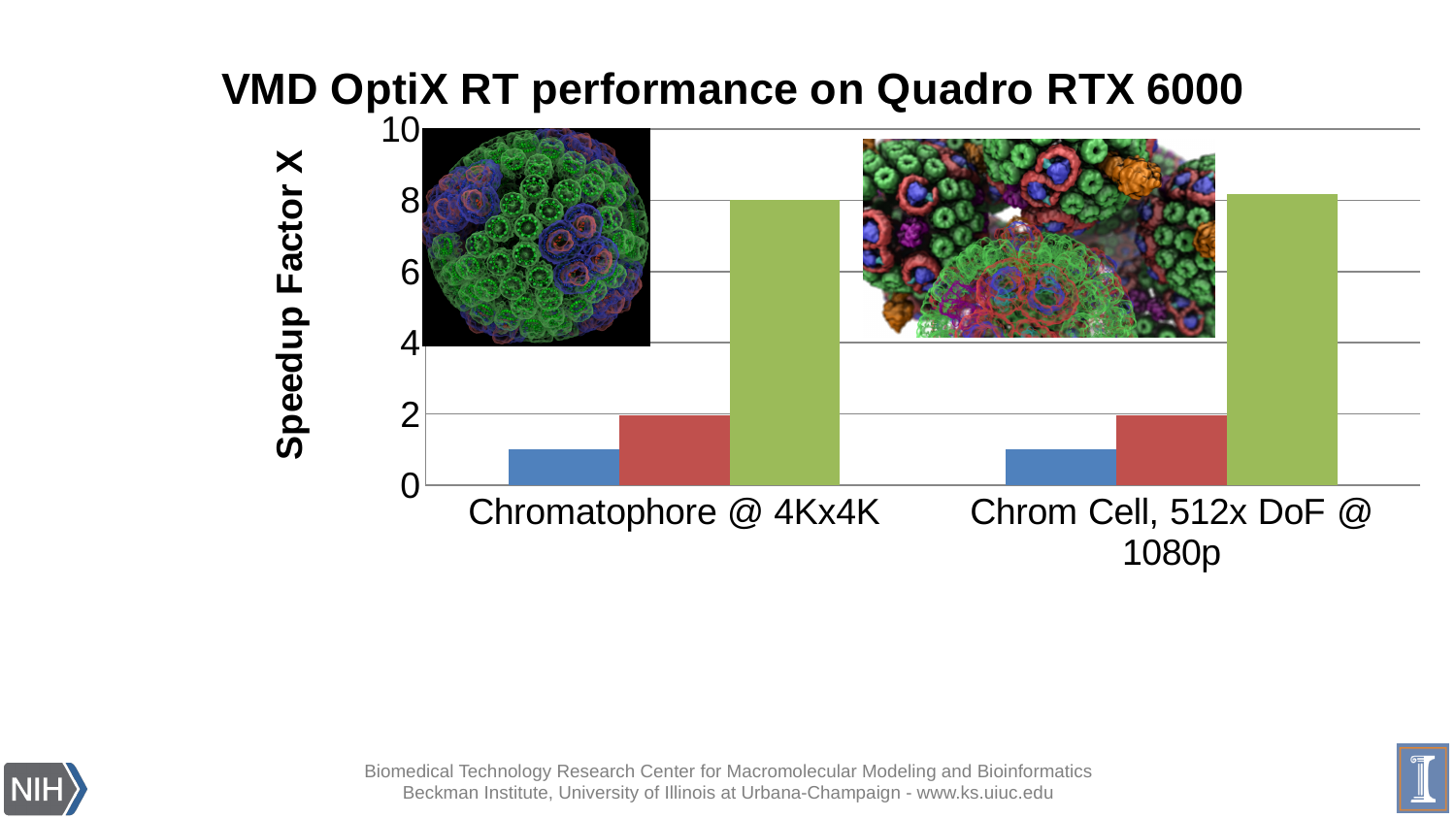
What is the title of the chart? VMD OptiX RT performance on Quadro RTX 6000 Is the blue bar for 'Chrom Cell, 512x DoF @ 1080p' greater or less than 2? less How many categories are shown on the x axis of the chart? 2 Which coloured bar is the tallest for 'Chromatophore @ 4Kx4K'? green Is the green bar for 'Chromatophore @ 4Kx4K' greater or less than 6? greater For 'Chromatophore @ 4Kx4K', which is larger: the green bar or the red bar? green bar Which coloured bar is the shortest for 'Chrom Cell, 512x DoF @ 1080p'? blue Is the red bar for 'Chrom Cell, 512x DoF @ 1080p' greater or less than 4? less What kind of chart is shown on the slide? bar chart How many bars are plotted for the category 'Chromatophore @ 4Kx4K'? 3 What is the label on the vertical axis of the chart? Speedup Factor X